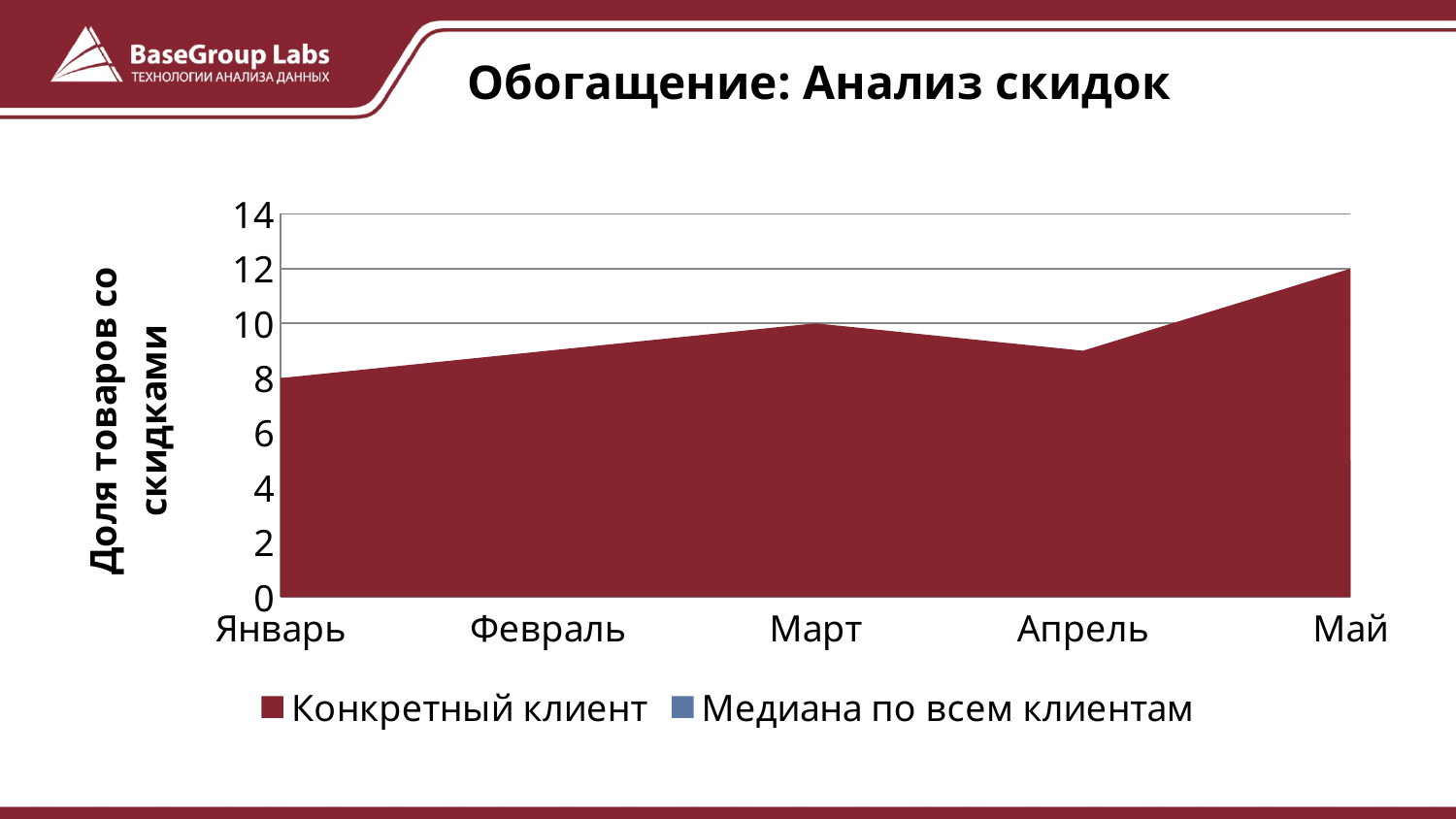
What is the title of the slide? Обогащение: Анализ скидок In which month is the value for Конкретный клиент lowest? Январь What is the value for Конкретный клиент in Март? 10 In which month is the value for Конкретный клиент highest? Май How many series does the legend list? 2 What kind of chart is shown on the slide? Area chart Is the value for Февраль greater or less than 10? less Is the value for Апрель greater or less than 8? greater What is the value for Конкретный клиент in Январь? 8 What is the difference between the values for Май and Январь? 4 What is the value for Конкретный клиент in Май? 12 How many months are shown on the x axis? 5